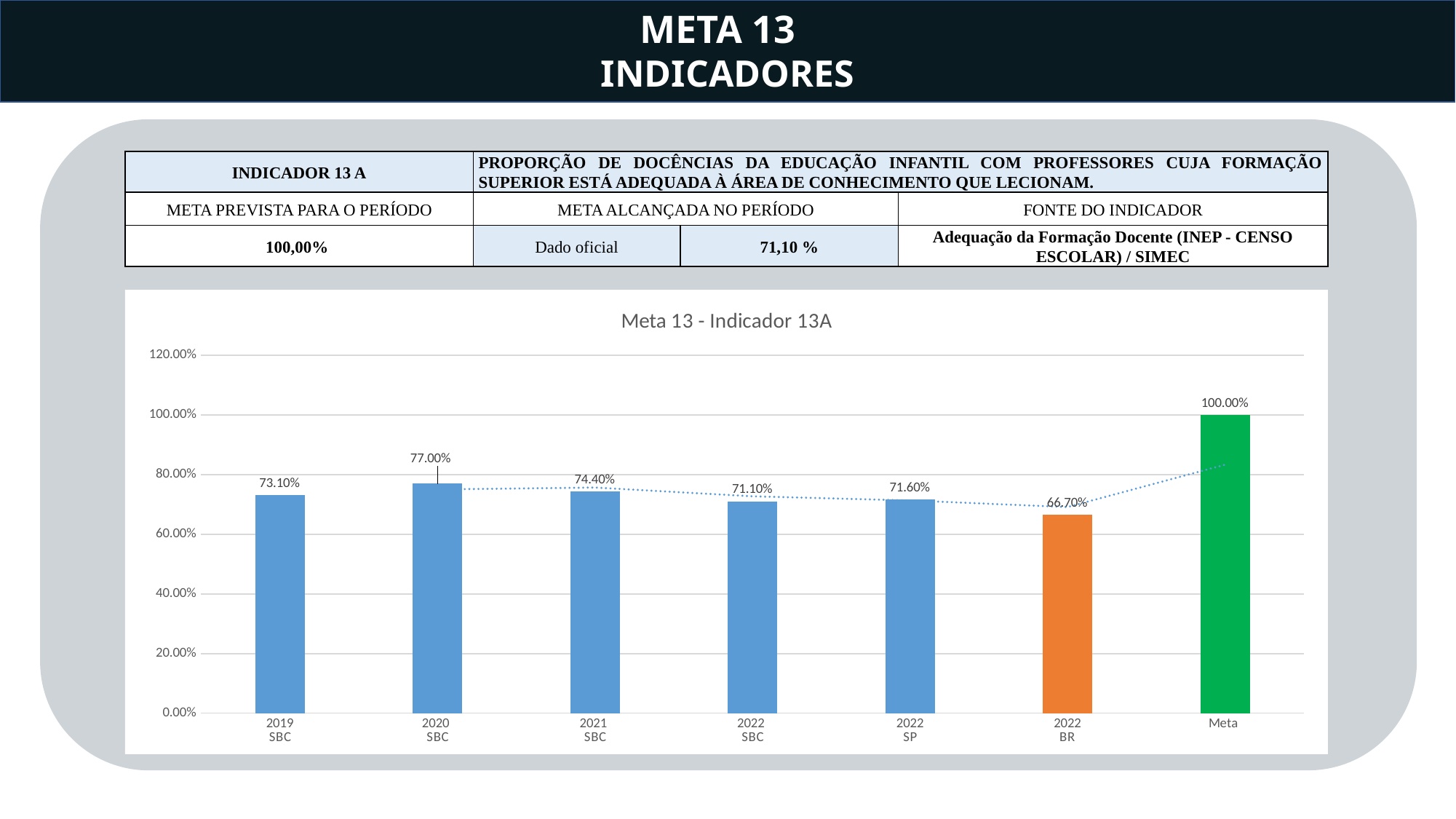
What is the value for 2022 SP? 71.60% What kind of chart is this? bar chart What is the value for 2019 SBC? 73.10% Which category has the lowest value? 2022 BR What is the value for 2022 BR? 66.70% What is the difference between the Meta value and the 2022 SBC value? 28.90% What is the title of the chart? Meta 13 - Indicador 13A Which is larger, the value for 2020 SBC or the value for 2021 SBC? 2020 SBC How many categories are shown on the x axis? 7 Which category has the highest value? Meta Is the value for 2022 BR greater or less than 80.00%? less What colour is the Meta bar? green